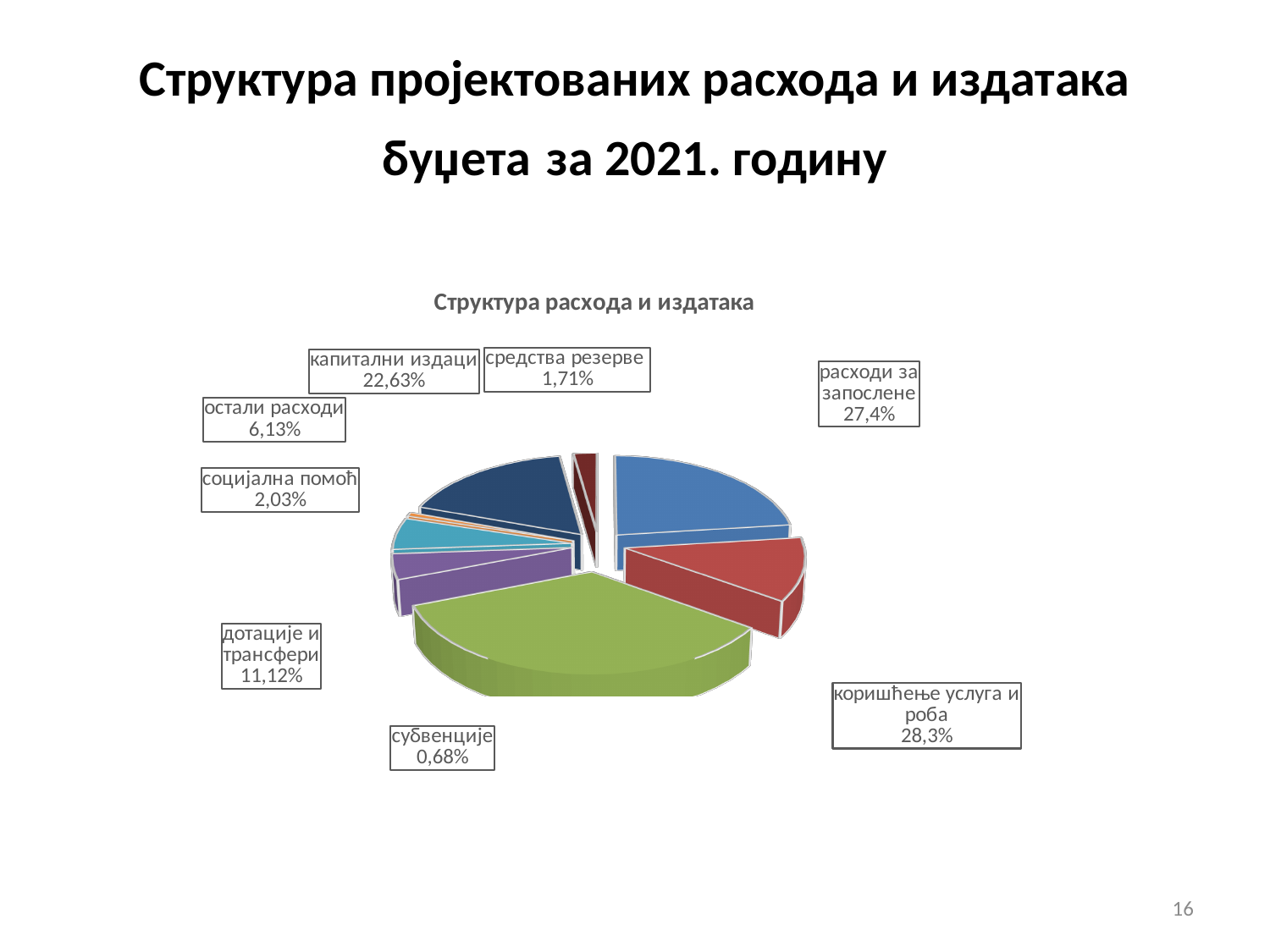
What is the difference between the shares for капитални издаци and дотације и трансфери? 11,51% How many categories (slices) does the pie chart have? 8 What is the difference between the shares for коришћење услуга и роба and расходи за запослене? 0,9% What type of chart is shown on the slide? pie chart What share of the pie is labelled for расходи за запослене? 27,4% What value is labelled for дотације и трансфери? 11,12% What percentage is shown for средства резерве? 1,71% What percentage is shown for капитални издаци? 22,63% What is the title of the chart? Структура расхода и издатака